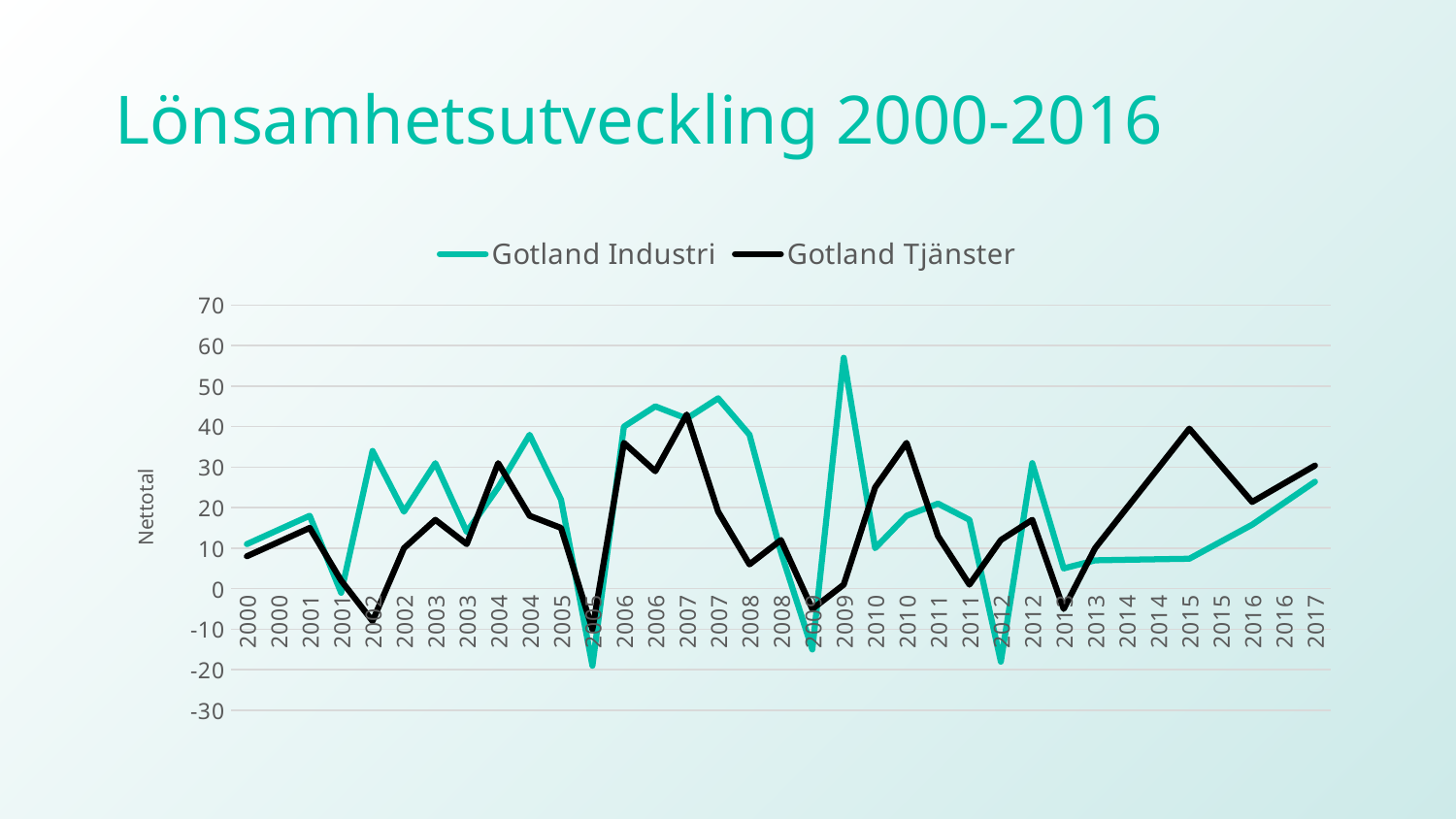
Which series reaches the highest value anywhere on the chart? Gotland Industri Does the Gotland Tjänster line rise or fall between 2013 and the first 2015 point? rise Is the peak value for Gotland Industri in 2009 greater or less than 50? greater Is the value for Gotland Tjänster at the first 2015 point greater or less than 30? greater At the first 2009 point, which series has the larger value, Gotland Industri or Gotland Tjänster? Gotland Tjänster What is the label on the vertical axis? Nettotal In which year does Gotland Industri reach its highest value? 2009 What is the title of the chart on the slide? Lönsamhetsutveckling 2000-2016 What kind of chart is shown on the slide? Line chart How many series does the legend list? 2 Is the value for Gotland Industri at the first 2015 point greater or less than 20? less At the first 2015 point, which series has the larger value, Gotland Industri or Gotland Tjänster? Gotland Tjänster